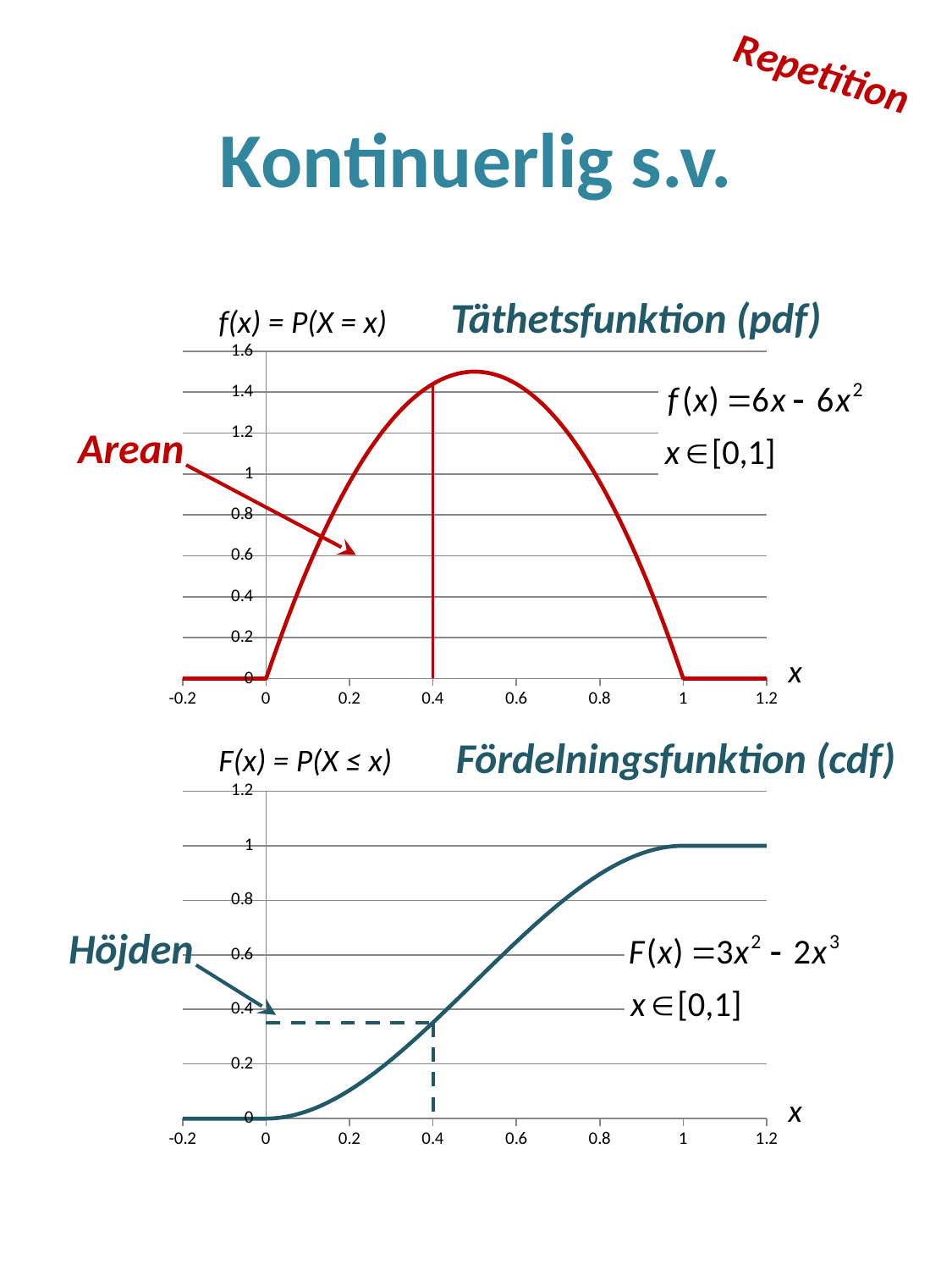
In the top chart 'Täthetsfunktion (pdf)', what is the value of f(x) at x = 1? 0 What kind of chart is the bottom chart titled 'Fördelningsfunktion (cdf)'? line chart In the top chart 'Täthetsfunktion (pdf)', what is the highest value shown on the y axis? 1.6 In the bottom chart 'Fördelningsfunktion (cdf)', what is the value of F(x) at x = 1? 1 In the top chart 'Täthetsfunktion (pdf)', what is the value of f(x) at x = 0? 0 In the top chart 'Täthetsfunktion (pdf)', is the peak value of the curve greater or less than 1.2? greater How many tick labels are shown on the x axis of the bottom chart 'Fördelningsfunktion (cdf)'? 8 What formula is given for f(x) next to the top chart 'Täthetsfunktion (pdf)'? f(x) = 6x - 6x² What kind of chart is the top chart titled 'Täthetsfunktion (pdf)'? line chart In the bottom chart 'Fördelningsfunktion (cdf)', is the value of F(x) at x = 0.4 greater or less than 0.4? less In the bottom chart 'Fördelningsfunktion (cdf)', does F(x) rise or fall as x increases from 0 to 1? rise In the top chart 'Täthetsfunktion (pdf)', is the value of f(x) at x = 0.4 greater or less than 1.2? greater